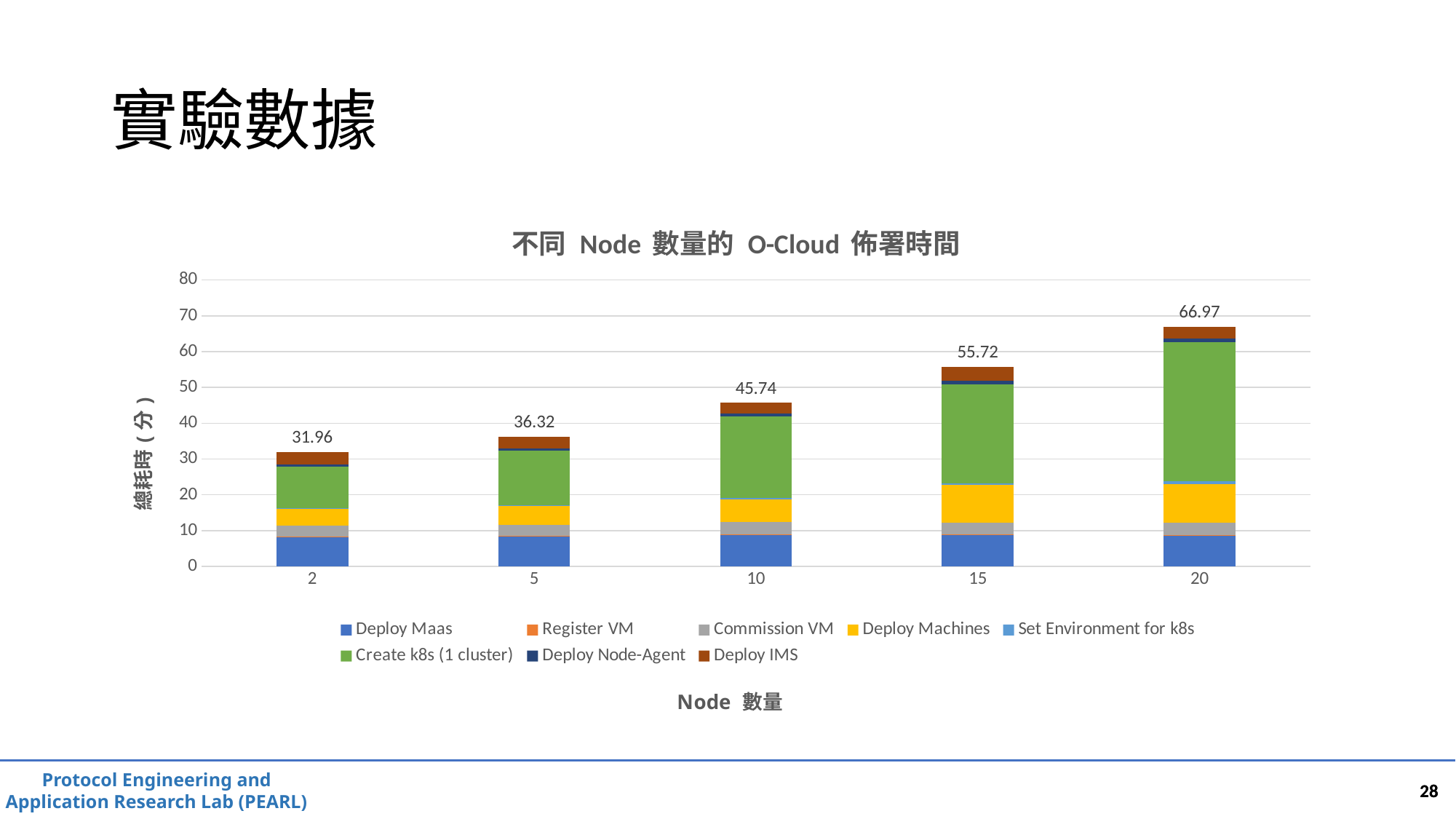
What kind of chart is shown on the slide? stacked bar chart Is the total deployment time for 5 nodes greater or less than 40? less Does the total deployment time rise or fall as the node count increases along the x axis? rise How many node-count categories are shown on the x axis? 5 Which has a larger total deployment time, 10 nodes or 15 nodes? 15 nodes What is the total deployment time shown for 2 nodes? 31.96 Which node count has the lowest total deployment time? 2 What is the difference between the total deployment time for 15 nodes and for 5 nodes? 19.40 What is the total deployment time shown for 20 nodes? 66.97 How many series does the legend list? 8 Which node count has the highest total deployment time? 20 What is the total deployment time shown for 10 nodes? 45.74